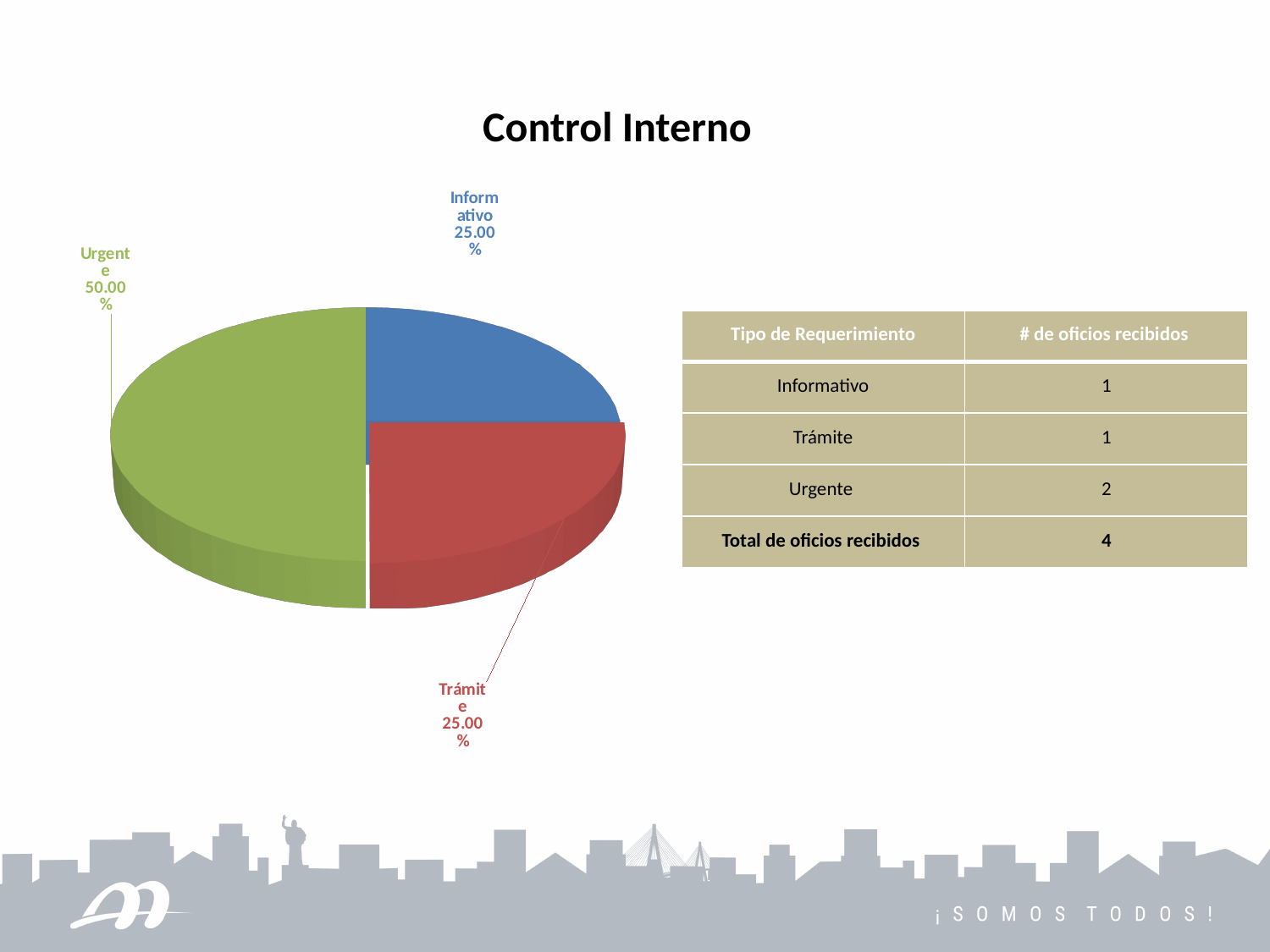
Which is larger, the Urgente slice or the Trámite slice? Urgente What share of the pie does the Urgente slice represent? 50.00% What kind of chart is shown on the slide? pie chart What colour is the Urgente slice of the pie chart? green What is the title of the slide containing the pie chart? Control Interno How many slices does the pie chart have? 3 What is the difference in percentage points between the Urgente slice and the Informativo slice? 25.00% What share of the pie does the Informativo slice represent? 25.00% What share of the pie does the Trámite slice represent? 25.00% Which category has the largest slice of the pie? Urgente